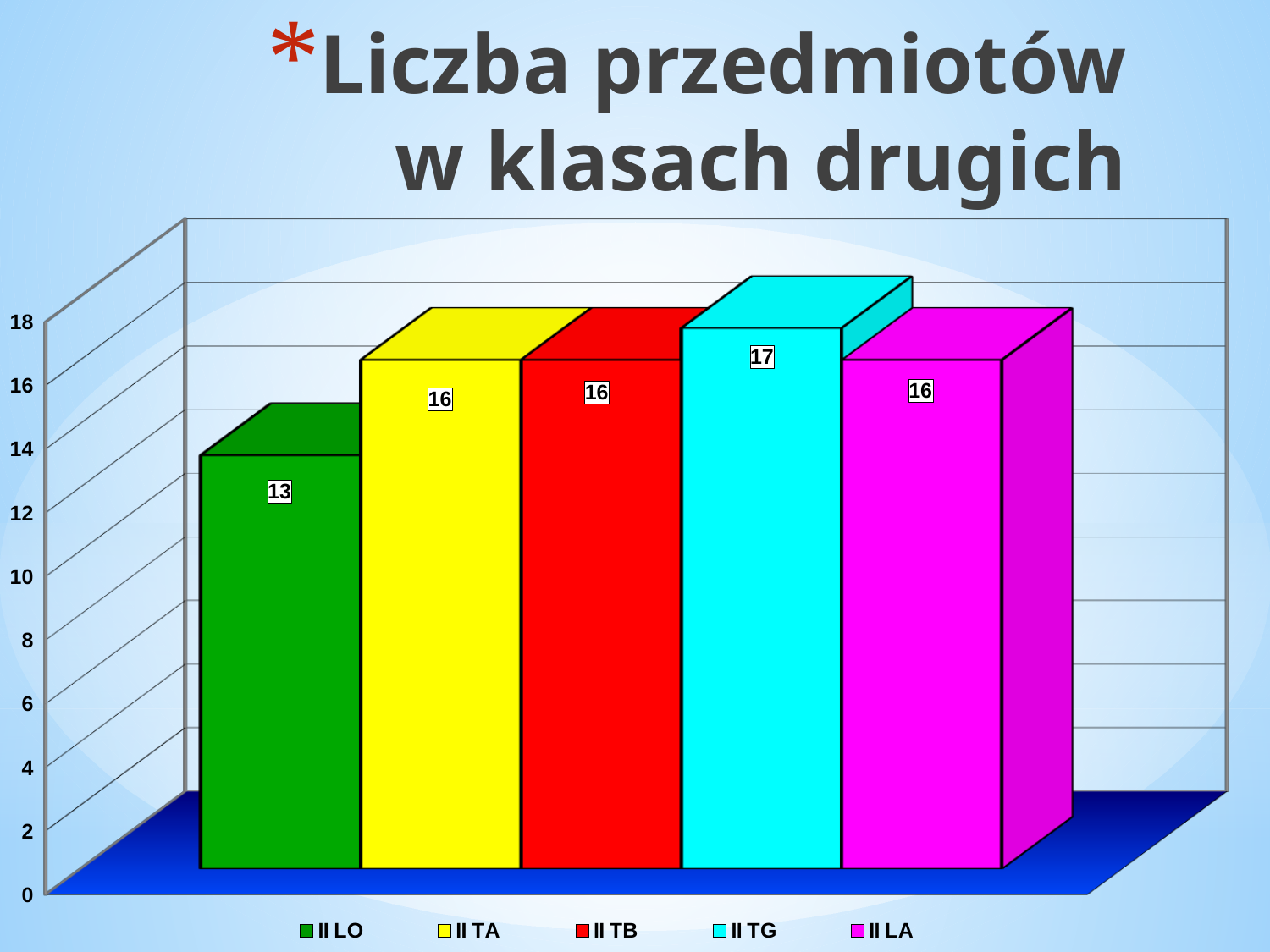
How many classes are shown in the chart? 5 What colour is the bar for II TB? red How many entries does the legend list? 5 Which is larger, the value for II TA or the value for II LO? II TA What is the value for II LO? 13 What is the value for II TG? 17 Which class has the lowest number of subjects? II LO What kind of chart is shown on the slide? bar chart Which class has the highest number of subjects? II TG Is the value for II LO greater or less than 14? less What is the difference between the values for II TG and II LO? 4 What is the value for II LA? 16